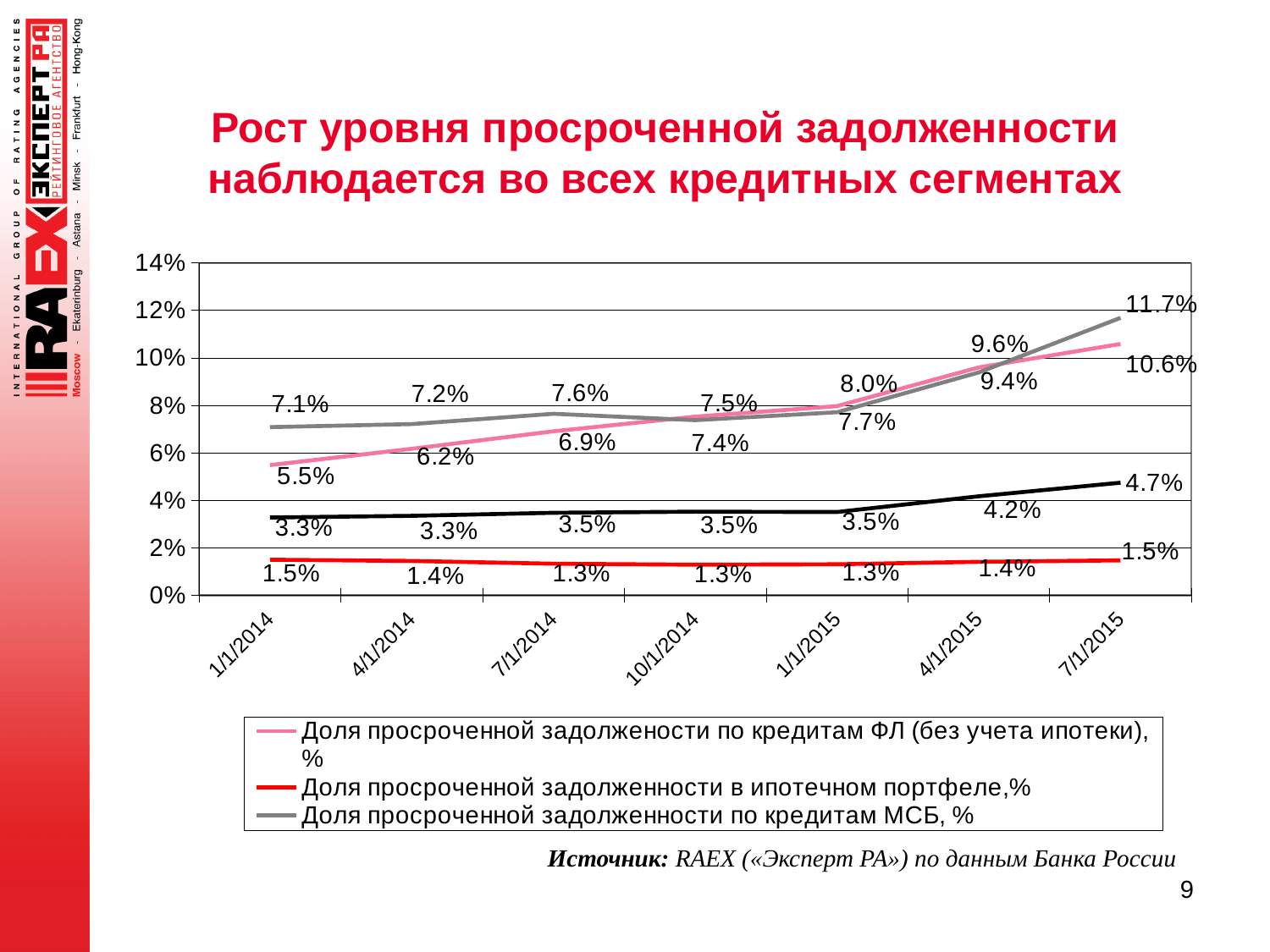
On which date is 'Доля просроченной задолженности по кредитам МСБ, %' highest? 7/1/2015 What is the value of 'Доля просроченной задолжености по кредитам ФЛ (без учета ипотеки), %' on 1/1/2014? 5.5% Does 'Доля просроченной задолжености по кредитам ФЛ (без учета ипотеки), %' rise or fall from 1/1/2014 to 7/1/2015? Rise What is the value of 'Доля просроченной задолженности по кредитам МСБ, %' on 7/1/2015? 11.7% What is the value of 'Доля просроченной задолженности в ипотечном портфеле,%' on 7/1/2014? 1.3% What colour is the line for 'Доля просроченной задолженности в ипотечном портфеле,%'? Red How many series does the legend list? 3 On which date is 'Доля просроченной задолжености по кредитам ФЛ (без учета ипотеки), %' lowest? 1/1/2014 On 1/1/2014, which is larger: the МСБ series or the ФЛ (без учета ипотеки) series? Доля просроченной задолженности по кредитам МСБ, % What is the difference between the МСБ series and the ФЛ (без учета ипотеки) series on 7/1/2015? 1.1% What type of chart is shown on the slide? Line chart How many dates are shown on the x axis? 7